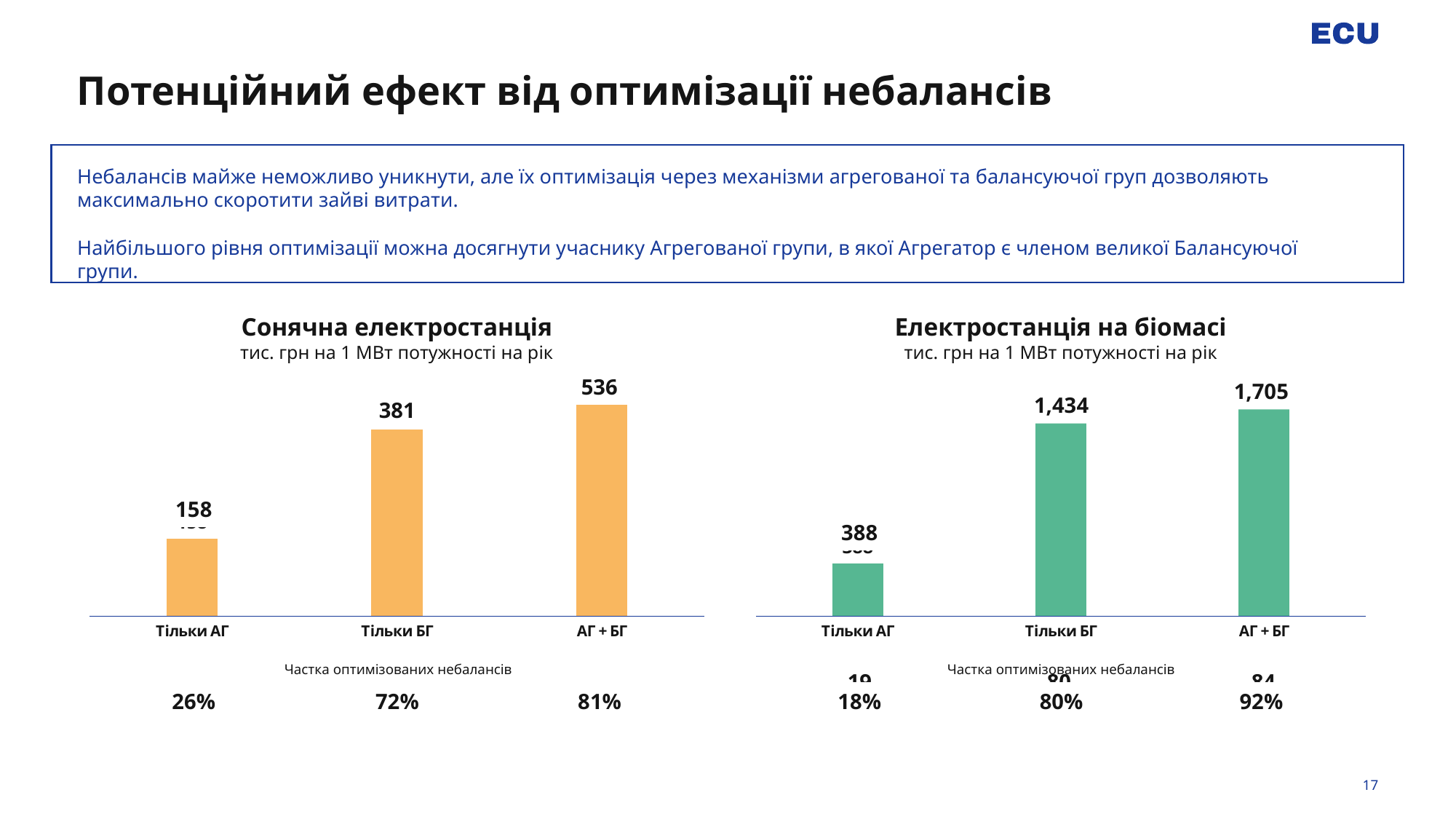
In the 'Сонячна електростанція' chart, what is the difference between the values for 'АГ + БГ' and 'Тільки БГ'? 155 What type of chart is the 'Сонячна електростанція' chart? Bar chart In the 'Електростанція на біомасі' chart, what is the value for 'Тільки БГ'? 1,434 In the 'Електростанція на біомасі' chart, which category has the lowest value? Тільки АГ In the 'Сонячна електростанція' chart, which category has the highest value? АГ + БГ Which is larger: the value for 'Тільки БГ' in the 'Сонячна електростанція' chart or the value for 'Тільки АГ' in the 'Електростанція на біомасі' chart? Тільки АГ in Електростанція на біомасі In the 'Сонячна електростанція' chart, what is the value for 'АГ + БГ'? 536 In the 'Електростанція на біомасі' chart, what is the difference between the values for 'Тільки БГ' and 'Тільки АГ'? 1,046 In the 'Сонячна електростанція' chart, what is the value for 'Тільки АГ'? 158 How many categories are shown in the 'Електростанція на біомасі' chart? 3 In the 'Сонячна електростанція' chart, do the values rise or fall from 'Тільки АГ' to 'АГ + БГ'? Rise In the 'Електростанція на біомасі' chart, what is the value for 'АГ + БГ'? 1,705